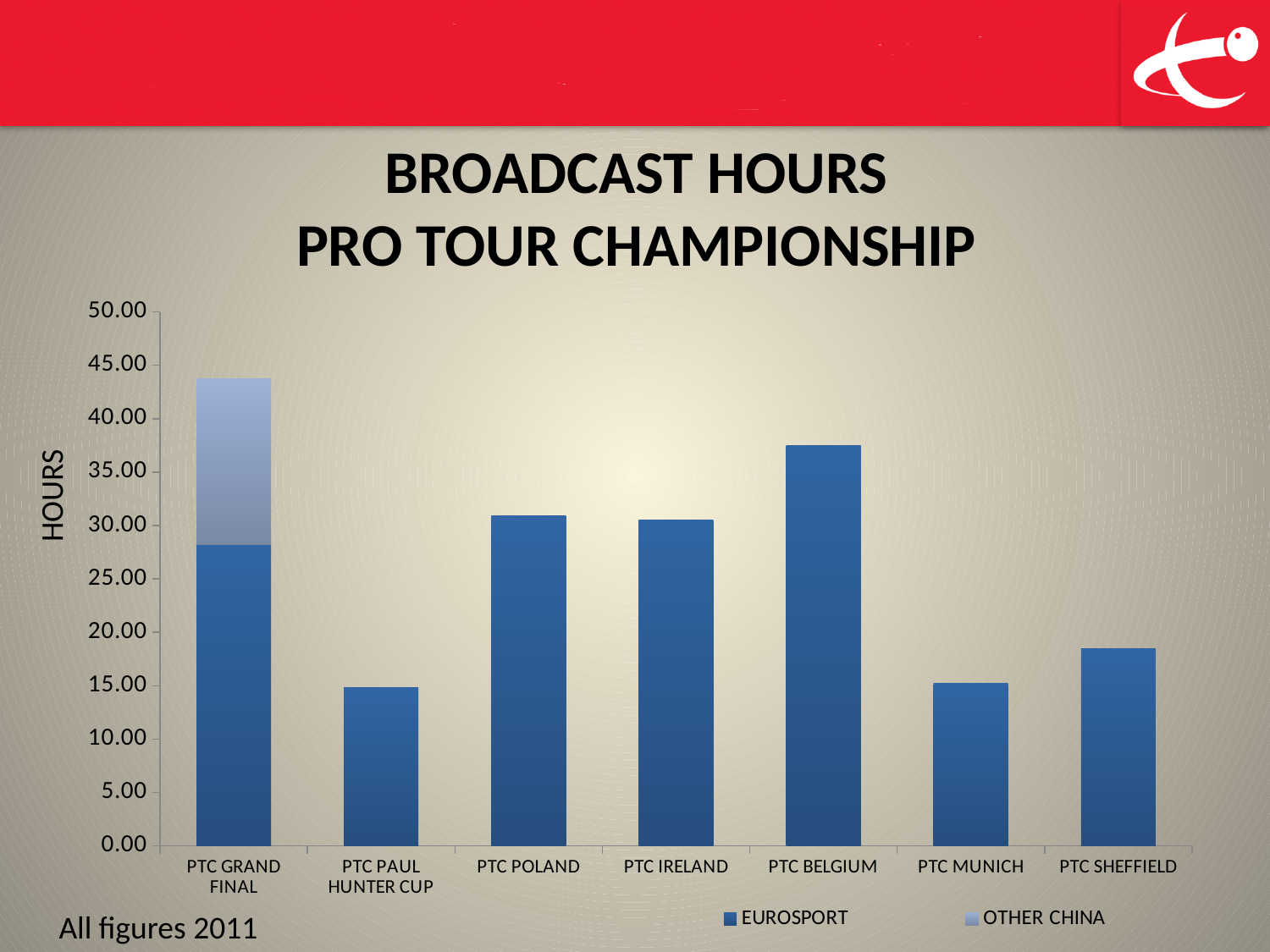
Which tournament has the tallest bar overall? PTC GRAND FINAL Which tournament is the only one with OTHER CHINA broadcast hours? PTC GRAND FINAL What is the label on the vertical axis? HOURS Which is larger, the bar for PTC POLAND or the bar for PTC MUNICH? PTC POLAND Is the value for PTC BELGIUM greater or less than 35.00? greater How many tournaments (categories) are shown on the x axis? 7 Is the value for PTC SHEFFIELD greater or less than 20.00? less Which is larger, the bar for PTC BELGIUM or the bar for PTC SHEFFIELD? PTC BELGIUM How many series does the legend list? 2 Which tournament has the most EUROSPORT broadcast hours? PTC BELGIUM What kind of chart is shown on the slide? Bar chart Is the total for PTC GRAND FINAL greater or less than 40.00? greater